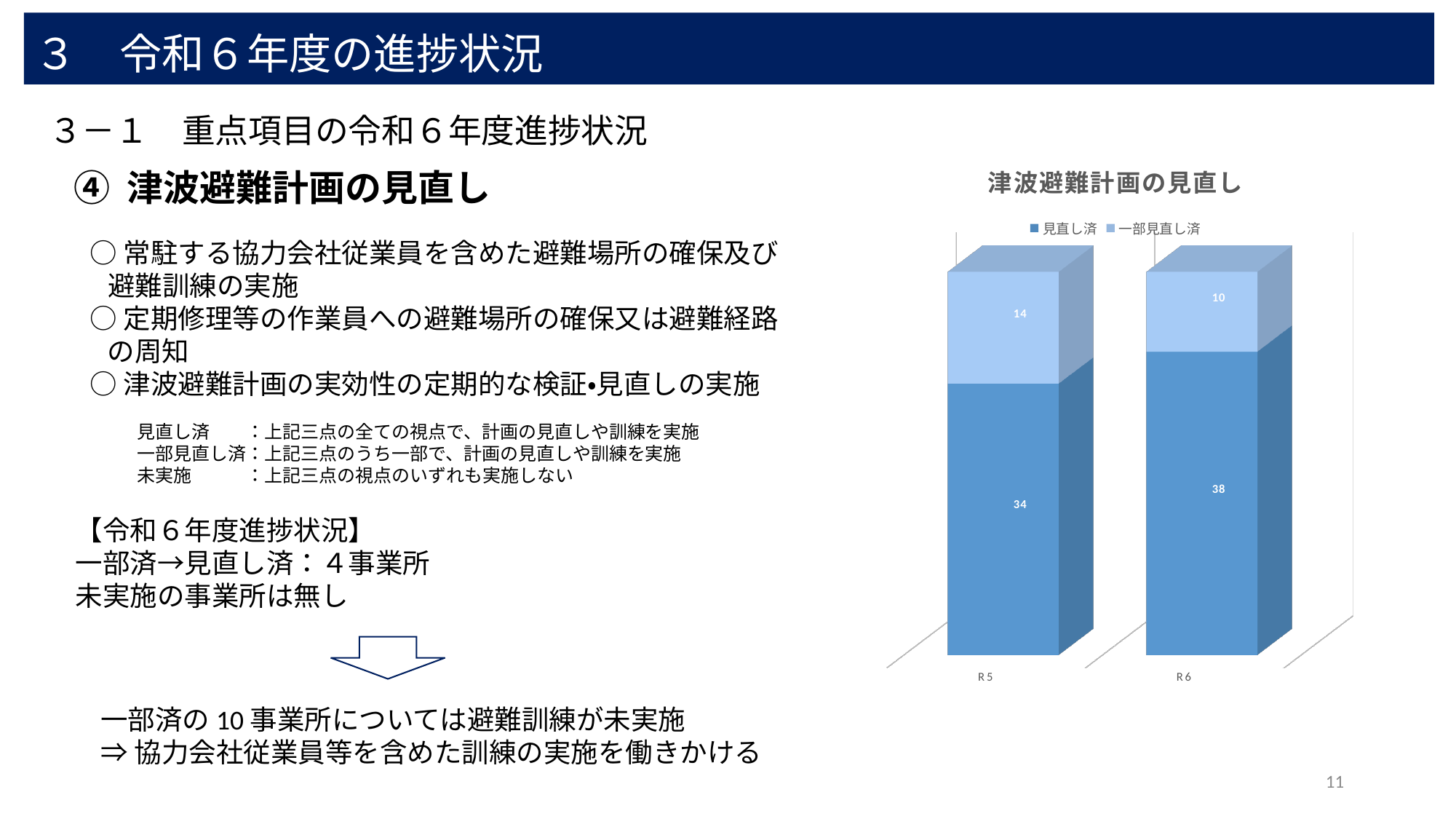
What is the value for 一部見直し済 in R6? 10 How many series does the legend list? 2 What is the difference between the 見直し済 values for R6 and R5? 4 What is the value for 一部見直し済 in R5? 14 What is the value for 見直し済 in R6? 38 What is the title of the chart? 津波避難計画の見直し How many categories are shown on the x axis? 2 What is the value for 見直し済 in R5? 34 What is the total of the stacked bar for R6? 48 What kind of chart is shown? Stacked bar chart What is the total of the stacked bar for R5? 48 Which is larger, the 一部見直し済 value for R5 or for R6? R5